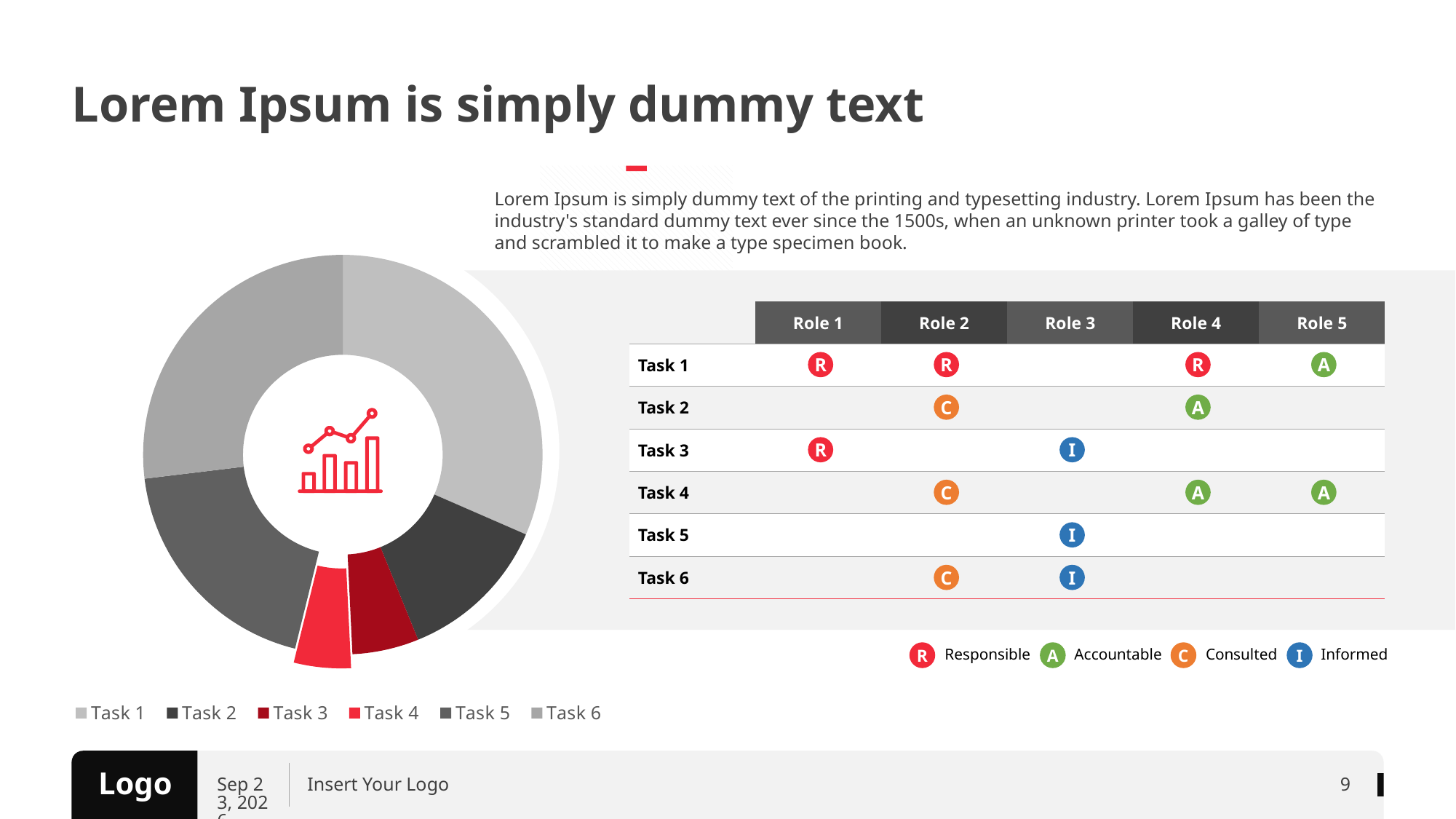
Which slice is larger in the doughnut chart, Task 2 or Task 3? Task 2 Which slice is larger in the doughnut chart, Task 1 or Task 3? Task 1 What kind of chart is shown on the left of the slide? doughnut chart What colour is the Task 4 slice in the doughnut chart? red Which category's slice is pulled out (exploded) from the doughnut chart? Task 4 Which slice is larger in the doughnut chart, Task 5 or Task 4? Task 5 How many categories (slices) does the doughnut chart have? 6 How many entries does the legend below the doughnut chart list? 6 Which category has the largest slice in the doughnut chart? Task 1